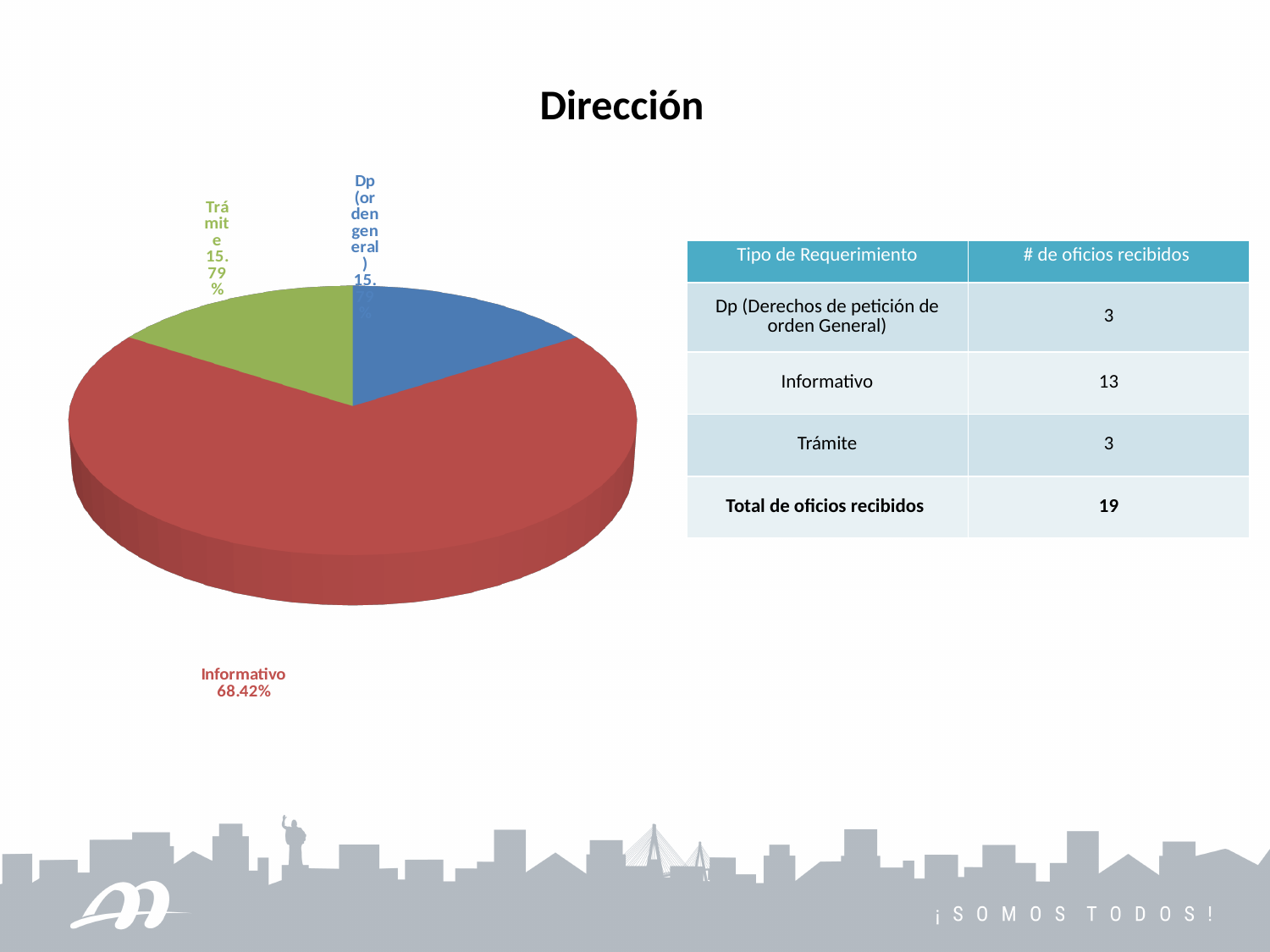
What kind of chart is shown on the slide? pie chart What colour is the Informativo slice in the pie chart? red Which slice is larger in the pie chart, Informativo or Trámite? Informativo What is the difference in percentage points between the Informativo slice and the Trámite slice? 52.63 Is the Informativo slice greater or less than 50% of the pie? greater Which category has the largest slice in the pie chart? Informativo What percentage does the Trámite slice represent in the pie chart? 15.79% What percentage does the Informativo slice represent in the pie chart? 68.42% How many slices does the pie chart have? 3